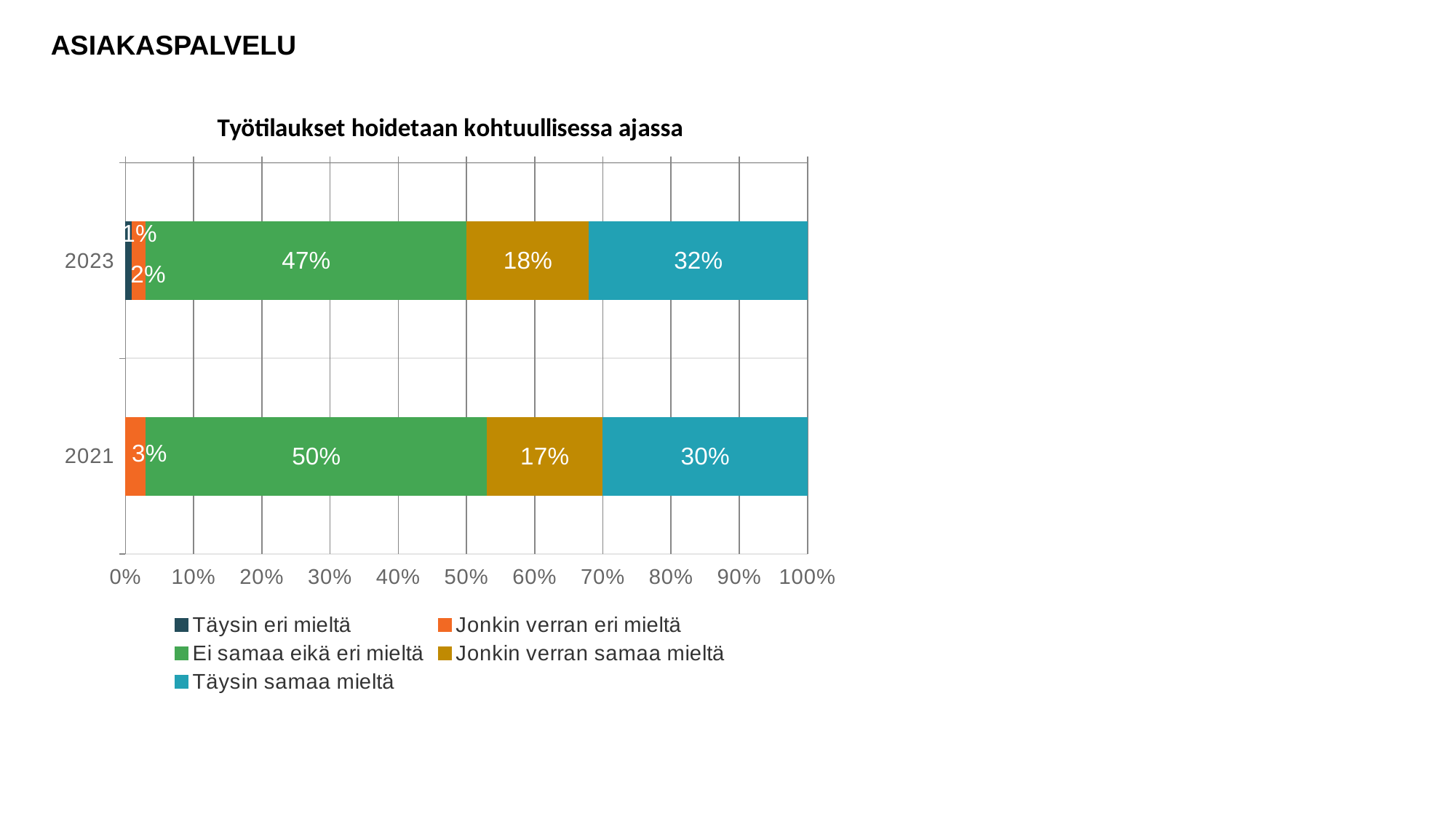
What is the value for "Täysin samaa mieltä" in 2021? 30% Which series has the lowest value in 2023? Täysin eri mieltä What is the difference between the "Ei samaa eikä eri mieltä" values for 2021 and 2023? 3% What kind of chart is shown on the slide? Stacked bar chart What is the title of the chart? Työtilaukset hoidetaan kohtuullisessa ajassa How many categories (years) are shown on the chart? 2 What is the value for "Ei samaa eikä eri mieltä" in 2023? 47% What is the value for "Jonkin verran samaa mieltä" in 2023? 18% Which year has the larger value for "Täysin samaa mieltä", 2021 or 2023? 2023 How many series does the legend list? 5 Which series has the highest value in 2021? Ei samaa eikä eri mieltä What is the value for "Jonkin verran eri mieltä" in 2021? 3%